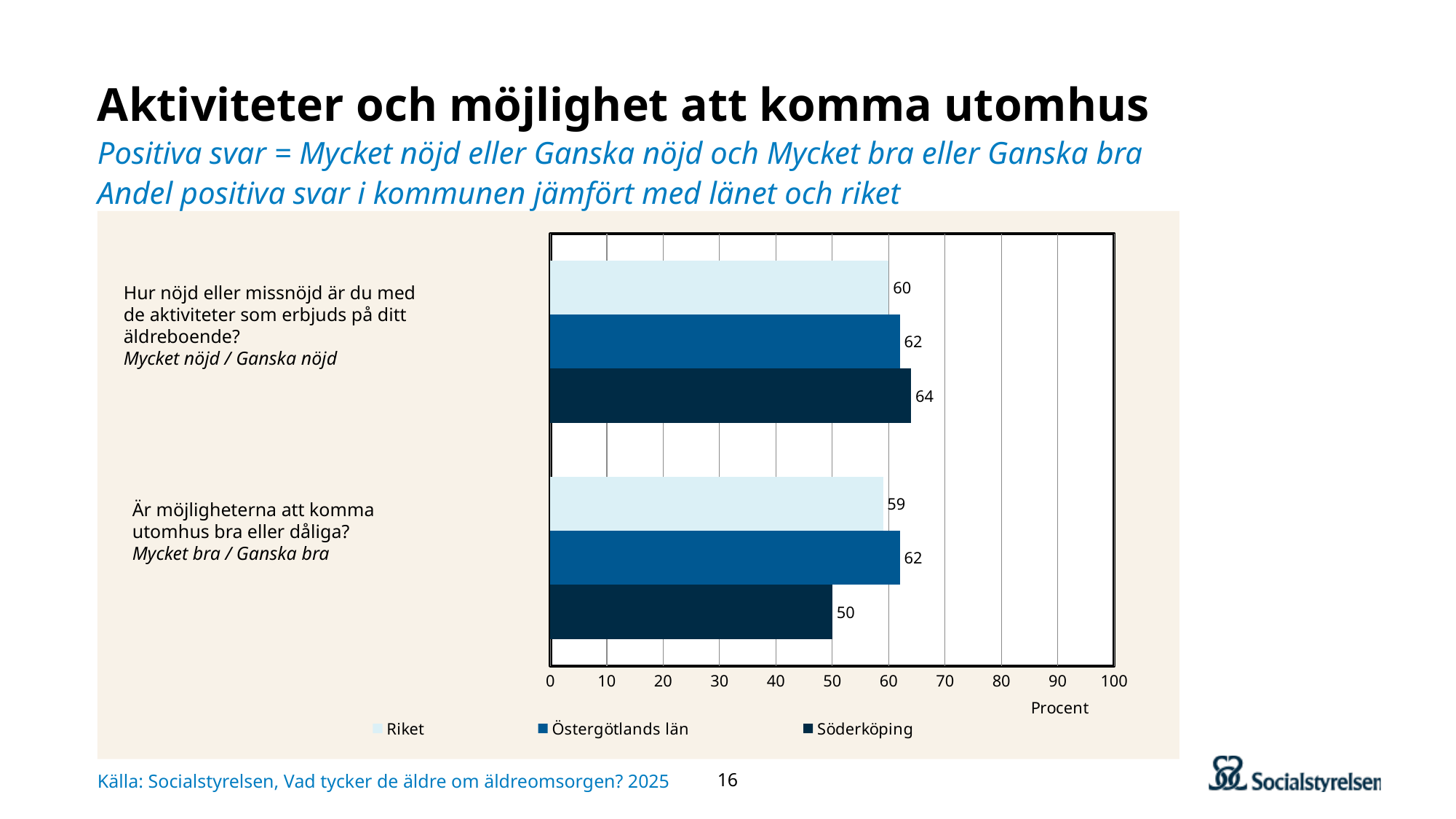
Which is larger on the question about satisfaction with activities offered: Riket or Söderköping? Söderköping What kind of chart is shown on the slide? Bar chart What is the value for Söderköping on the question about satisfaction with activities offered at the care home (Hur nöjd eller missnöjd är du med de aktiviteter som erbjuds på ditt äldreboende)? 64 Which series has the highest value on the question about satisfaction with activities offered? Söderköping How many series does the legend list? 3 What is the value for Söderköping on the question about opportunities to get outdoors? 50 Which series has the lowest value on the question about opportunities to get outdoors? Söderköping What is the value for Riket on the question about opportunities to get outdoors (Är möjligheterna att komma utomhus bra eller dåliga)? 59 What is the value for Östergötlands län on the question about satisfaction with activities offered? 62 Is the value for Söderköping on the question about opportunities to get outdoors greater or less than 60? less What unit is shown on the horizontal axis of the chart? Procent What is the difference between Östergötlands län and Söderköping on the question about opportunities to get outdoors? 12